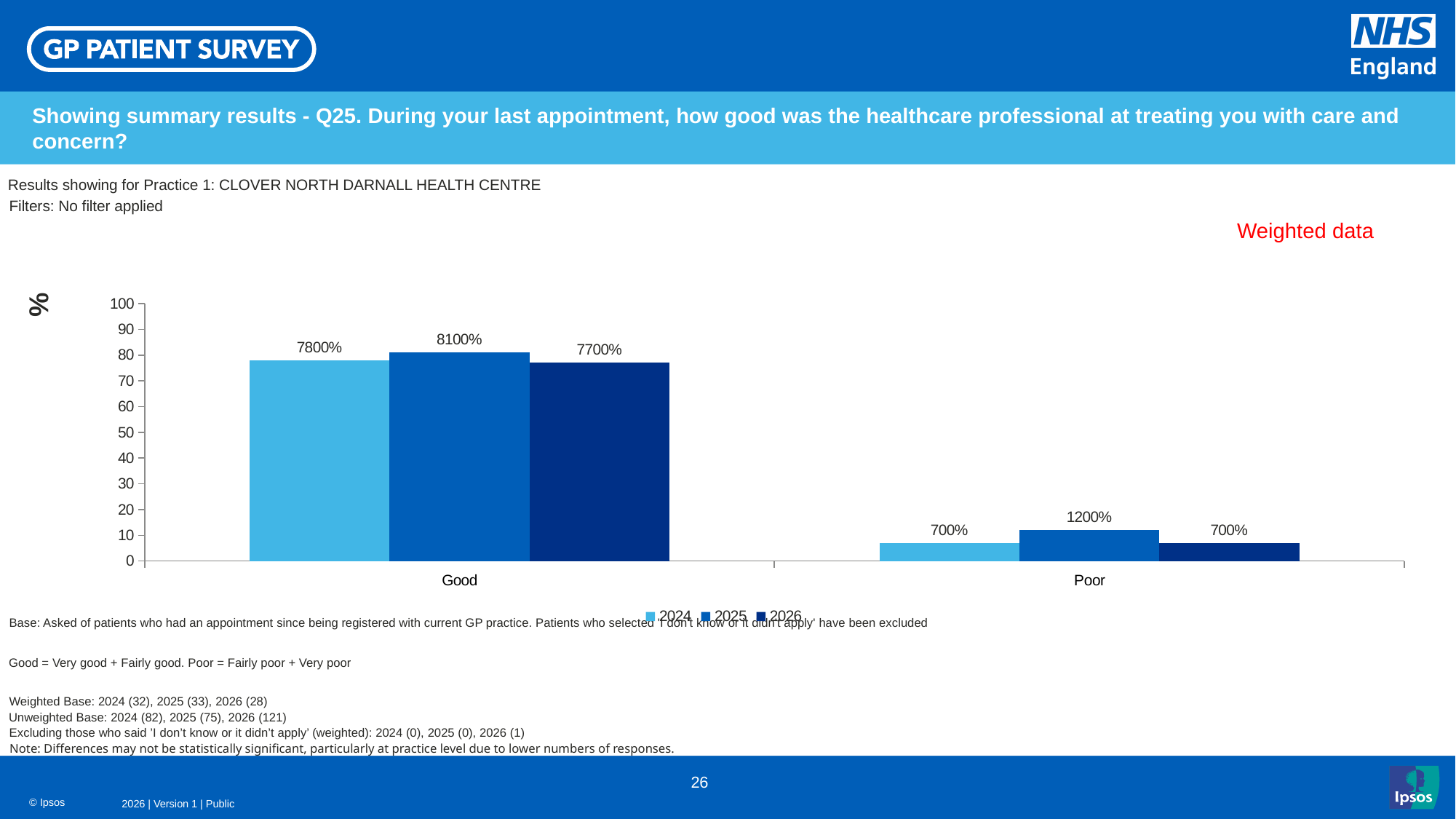
Which year has the lowest value in the Good category? 2026 How many categories are shown on the x axis? 2 What is the data label for the 2025 series in the Good category? 8100% Is the 2024 bar for Good greater or less than 70 on the axis? greater Which year has the highest value in the Good category? 2025 What is the data label for the 2025 series in the Poor category? 1200% What kind of chart is shown on the slide? bar chart What is the data label for the 2026 series in the Poor category? 700% What is the data label for the 2024 series in the Good category? 7800% Which year has the highest value in the Poor category? 2025 How many series does the legend list? 3 Is the 2024 value for Good larger or smaller than the 2026 value for Good? larger